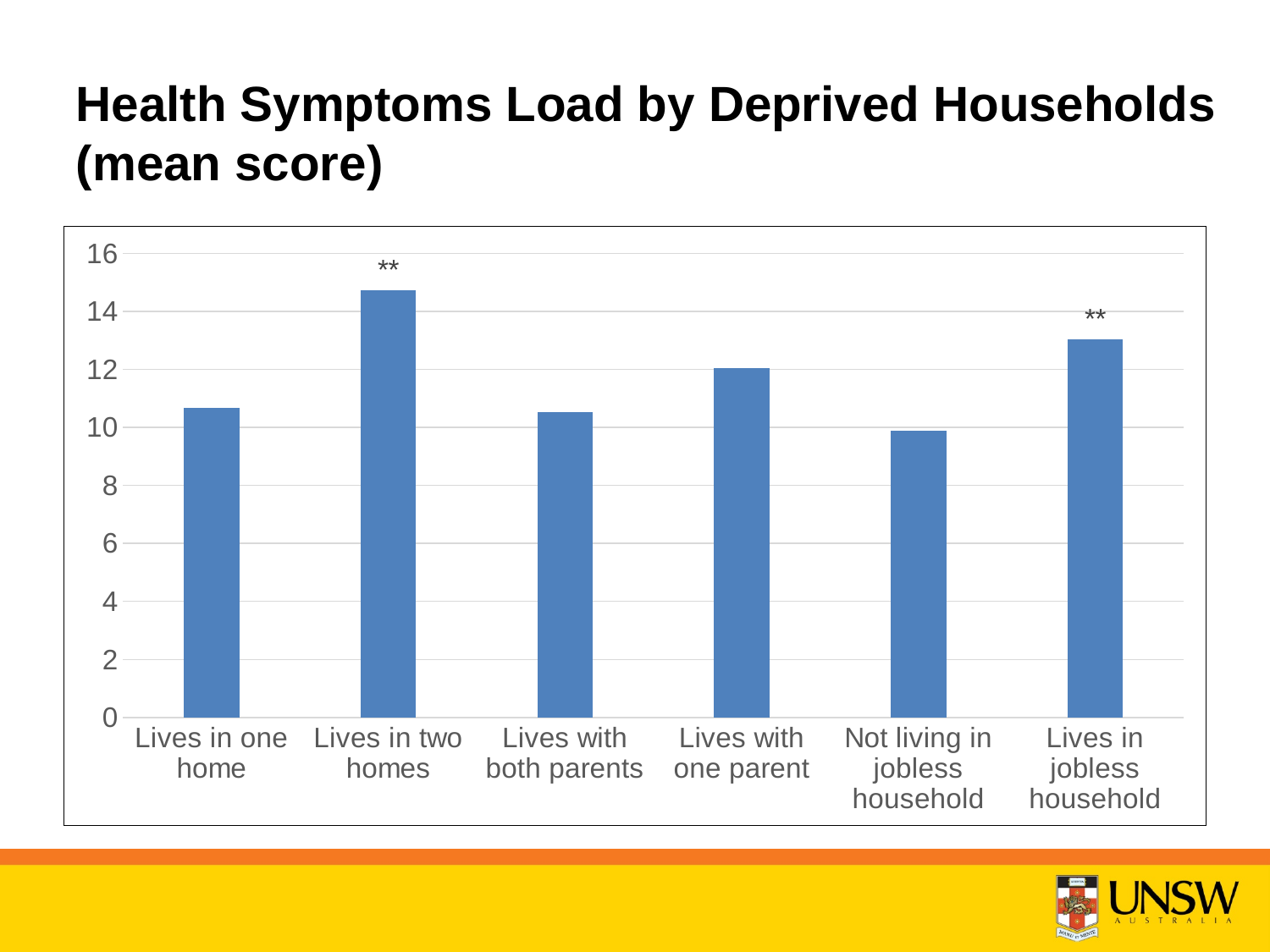
Is the value for 'Lives in jobless household' greater or less than 12? greater Which two categories are marked with '**' above their bars? Lives in two homes and Lives in jobless household Which has a higher mean score: 'Lives in two homes' or 'Lives in one home'? Lives in two homes Is the value for 'Lives in two homes' greater or less than 14? greater Which category has the highest mean health symptoms load score? Lives in two homes What kind of chart is shown on the slide? Bar chart Which has a higher mean score: 'Lives with one parent' or 'Lives with both parents'? Lives with one parent What is the title of the chart on the slide? Health Symptoms Load by Deprived Households (mean score) Which category has the lowest mean health symptoms load score? Not living in jobless household How many categories are plotted on the chart? 6 Which has a higher mean score: 'Lives in jobless household' or 'Not living in jobless household'? Lives in jobless household